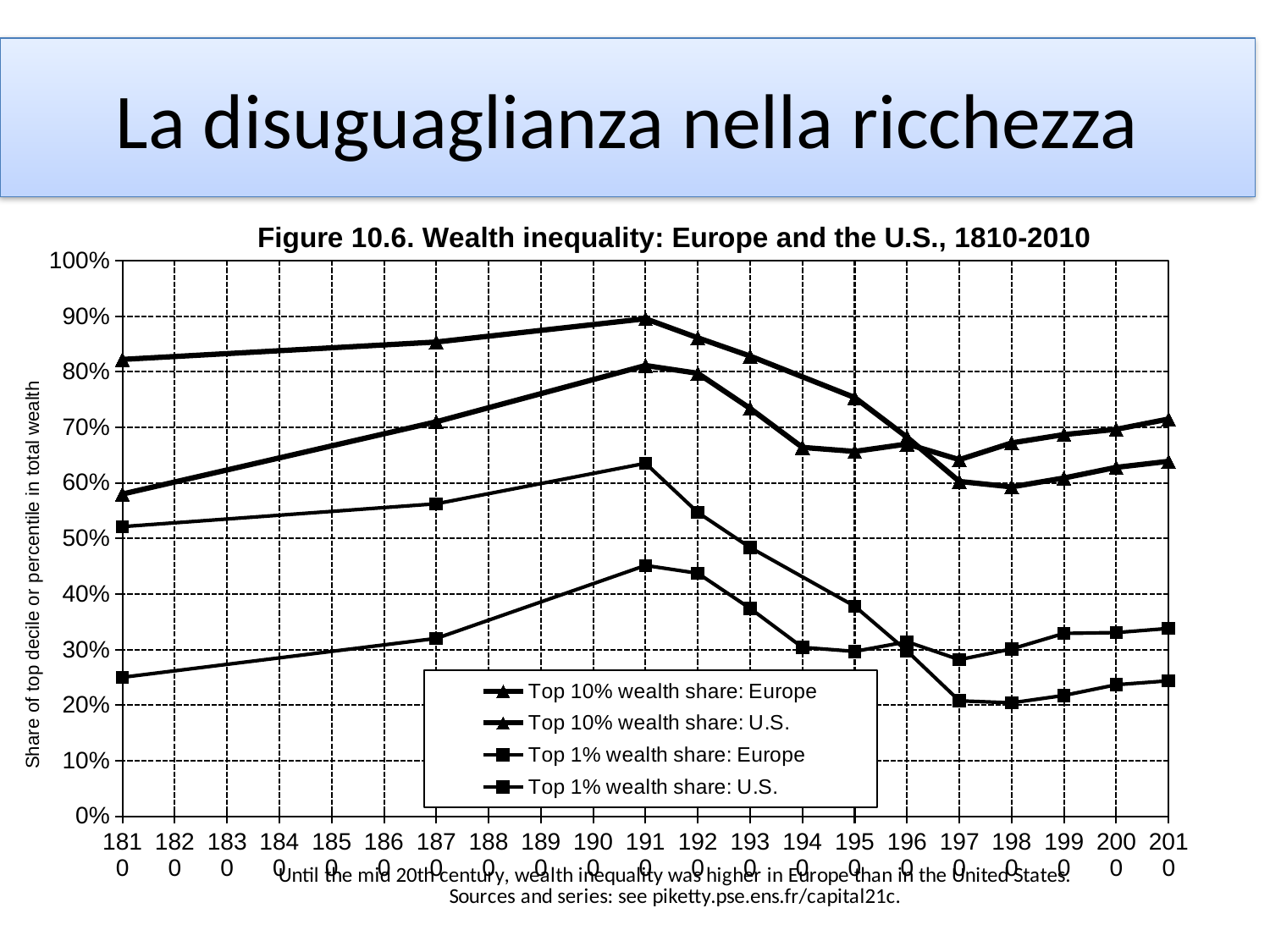
What is the title of the chart? Figure 10.6. Wealth inequality: Europe and the U.S., 1810-2010 How many series does the legend list? 4 Is the Top 1% wealth share for Europe in 1910 greater or less than 60%? greater Is the Top 10% wealth share for Europe in 1910 greater or less than 80%? greater Does the Top 1% wealth share for Europe rise or fall between 1910 and 1970? fall How many year labels are shown on the x axis? 21 In which year do the Top 10% wealth share series reach their highest values? 1910 In 1810, which is higher: the Top 10% wealth share for Europe or for the U.S.? Europe In 2010, which is higher: the Top 1% wealth share for Europe or for the U.S.? U.S. Is the Top 1% wealth share for the U.S. in 1810 greater or less than 30%? less What kind of chart is shown on the slide? line chart Which series has the lowest value in 1810? Top 1% wealth share: U.S.